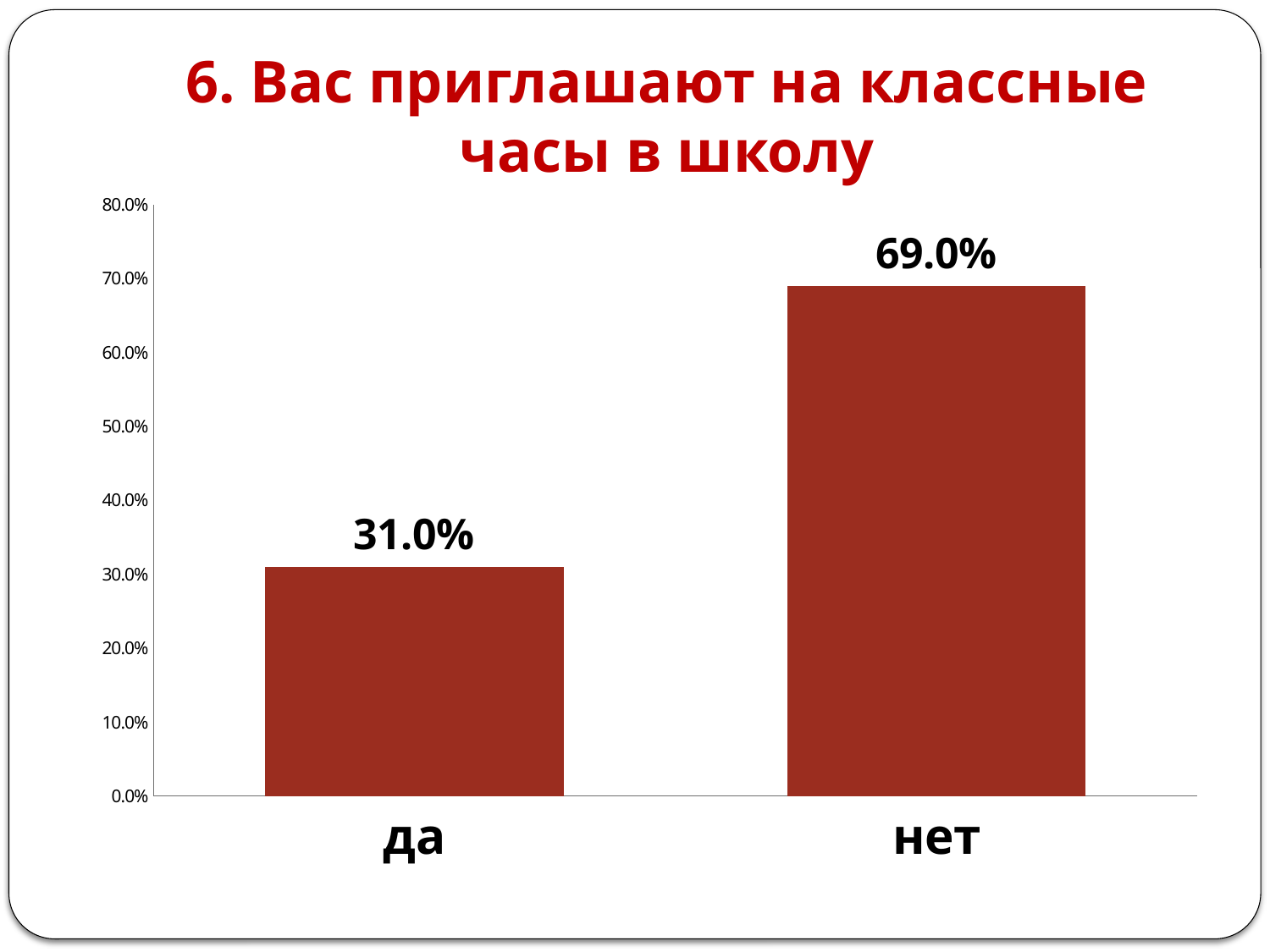
How many categories are shown on the chart? 2 What is the highest value shown on the vertical axis? 80.0% Is the value for "нет" greater or less than 60.0%? greater Which category has the highest value? нет What is the difference between the values for "нет" and "да"? 38.0% What kind of chart is shown on the slide? bar chart Which category has the lowest value? да What is the value for "да"? 31.0% Which is larger, the value for "да" or the value for "нет"? нет What is the value for "нет"? 69.0% What is the title of the slide? 6. Вас приглашают на классные часы в школу Is the value for "да" greater or less than 40.0%? less